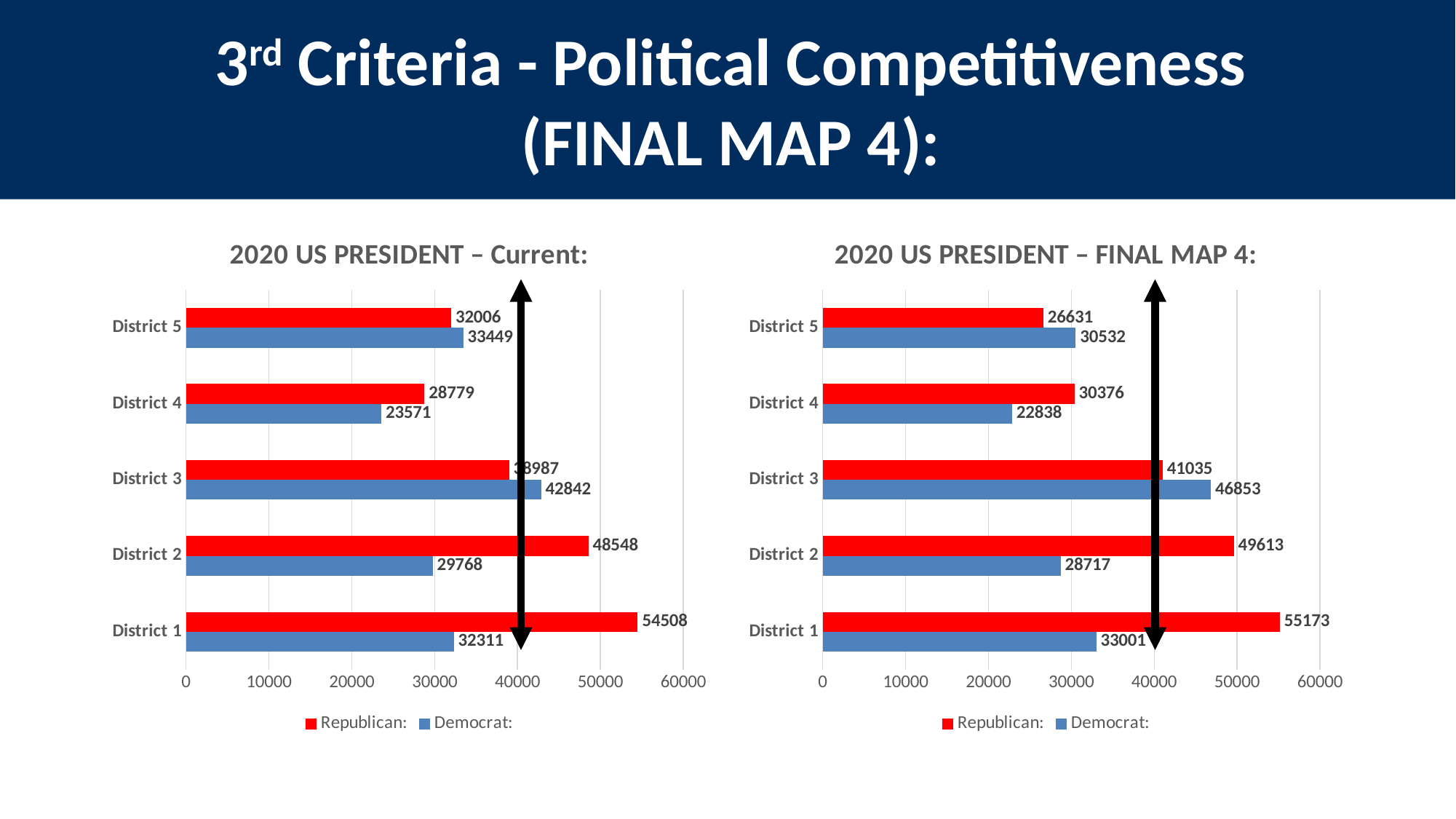
In the chart titled "2020 US PRESIDENT – FINAL MAP 4:", which district has the highest Republican value? District 1 In the chart titled "2020 US PRESIDENT – Current:", what is the difference between the Republican and Democrat values for District 2? 18780 In the chart titled "2020 US PRESIDENT – Current:", what colour represents the Republican series? Red In the chart titled "2020 US PRESIDENT – FINAL MAP 4:", what is the Democrat value for District 3? 46853 In the chart titled "2020 US PRESIDENT – Current:", is the Democrat value for District 3 greater or less than 40000? greater In the chart titled "2020 US PRESIDENT – FINAL MAP 4:", which is larger for District 5, the Republican value or the Democrat value? Democrat In the chart titled "2020 US PRESIDENT – Current:", what is the Republican value for District 1? 54508 In the chart titled "2020 US PRESIDENT – Current:", what is the Democrat value for District 4? 23571 How many series does the legend list in the chart titled "2020 US PRESIDENT – Current:"? 2 What type of chart is the one titled "2020 US PRESIDENT – FINAL MAP 4:"? Bar chart In the chart titled "2020 US PRESIDENT – FINAL MAP 4:", which district has the lowest Democrat value? District 4 How many districts are shown in the chart titled "2020 US PRESIDENT – FINAL MAP 4:"? 5